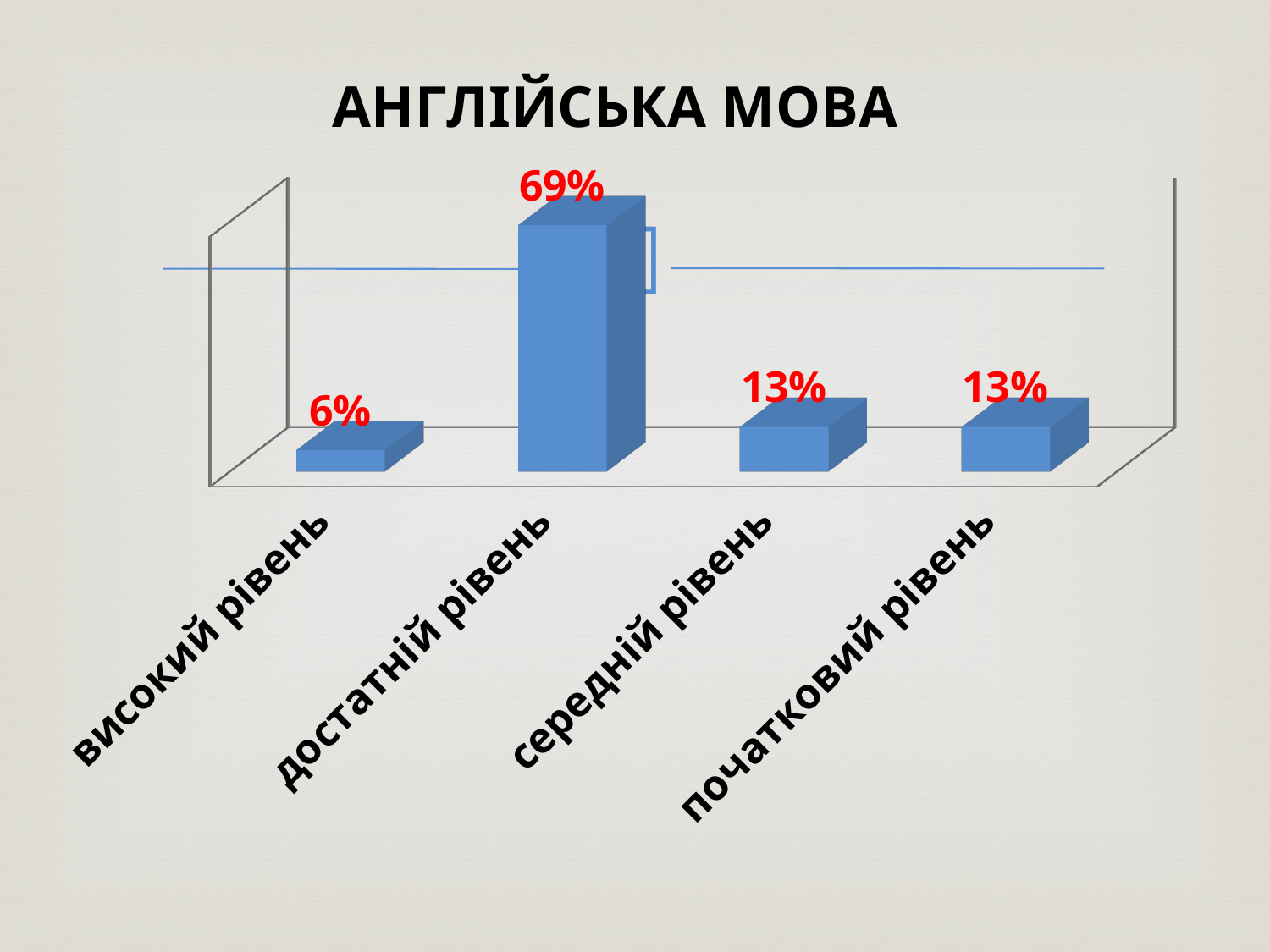
What is the value for високий рівень? 6% What is the value for достатній рівень? 69% What is the difference between the values for достатній рівень and середній рівень? 56% What kind of chart is shown on the slide? bar chart How many categories are shown in the chart? 4 What is the title of the slide? АНГЛІЙСЬКА МОВА What is the value for початковий рівень? 13% What is the value for середній рівень? 13% Which category has the highest value? достатній рівень Which is larger, the value for достатній рівень or the value for початковий рівень? достатній рівень What is the difference between the values for середній рівень and високий рівень? 7% Which category has the lowest value? високий рівень